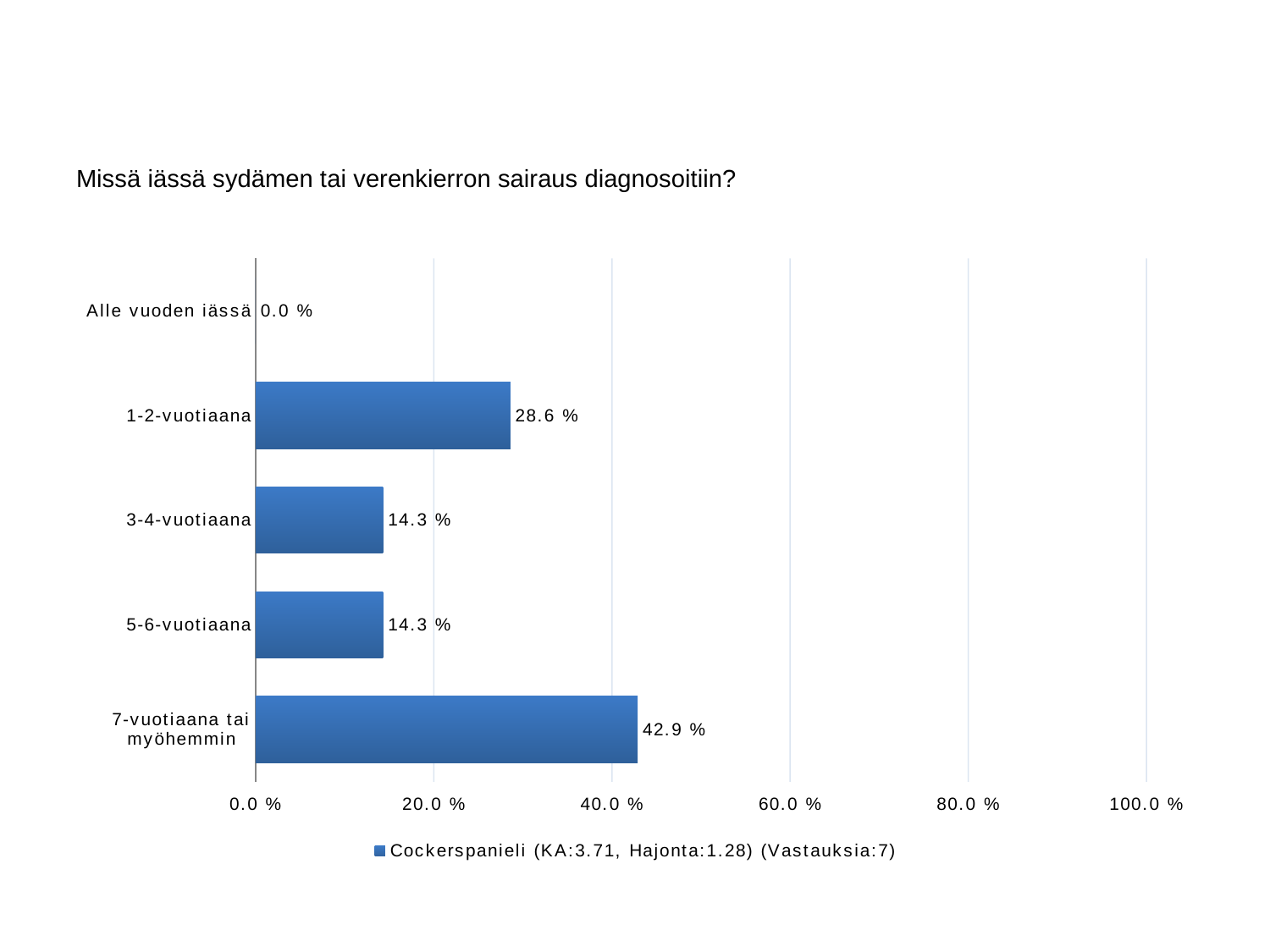
What is the value for 3-4-vuotiaana? 14.3 % Which category has the highest value? 7-vuotiaana tai myöhemmin What is the value for 1-2-vuotiaana? 28.6 % How many categories are shown in the chart? 5 What is the title of the chart? Missä iässä sydämen tai verenkierron sairaus diagnosoitiin? Which category has the lowest value? Alle vuoden iässä Which is larger, the value for 1-2-vuotiaana or the value for 5-6-vuotiaana? 1-2-vuotiaana What kind of chart is shown on the slide? bar chart Is the value for 7-vuotiaana tai myöhemmin greater or less than 40.0 %? greater What is the difference between the values for 7-vuotiaana tai myöhemmin and 1-2-vuotiaana? 14.3 % What is the value for Alle vuoden iässä? 0.0 % What is the value for 7-vuotiaana tai myöhemmin? 42.9 %